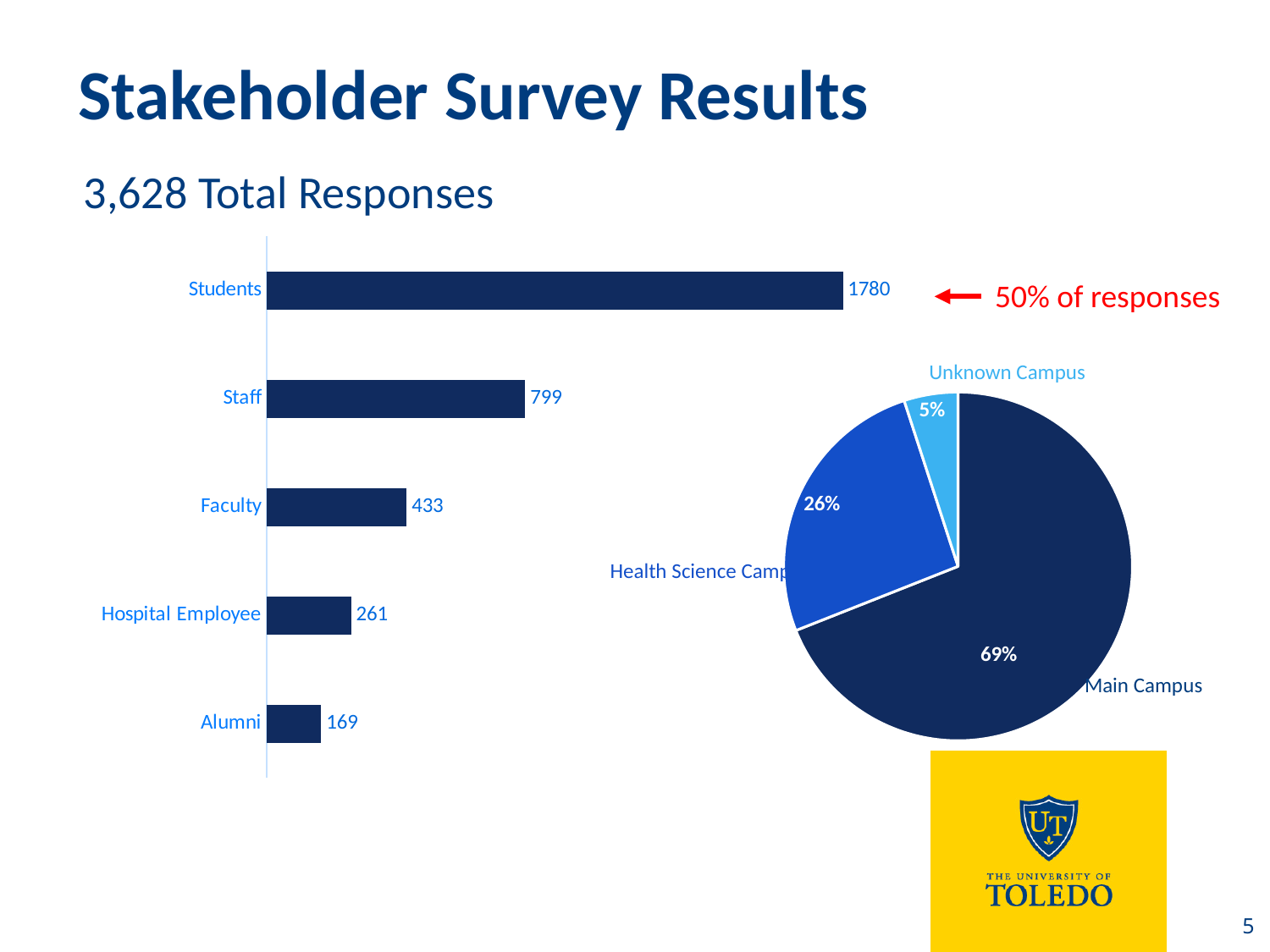
In the bar chart on the left, what is the value for Staff? 799 In the bar chart on the left, which category has the lowest value? Alumni In the bar chart on the left, what is the value for Students? 1780 In the pie chart on the right, which slice is the largest? Main Campus In the bar chart on the left, what is the value for Hospital Employee? 261 In the bar chart on the left, what is the difference between the values for Staff and Faculty? 366 What kind of chart is the chart on the left? Bar chart In the pie chart on the right, what share does Unknown Campus have? 5% How many categories does the bar chart on the left show? 5 In the pie chart on the right, what share does Main Campus have? 69% In the bar chart on the left, which is larger, the value for Faculty or the value for Hospital Employee? Faculty In the bar chart on the left, which category has the highest value? Students